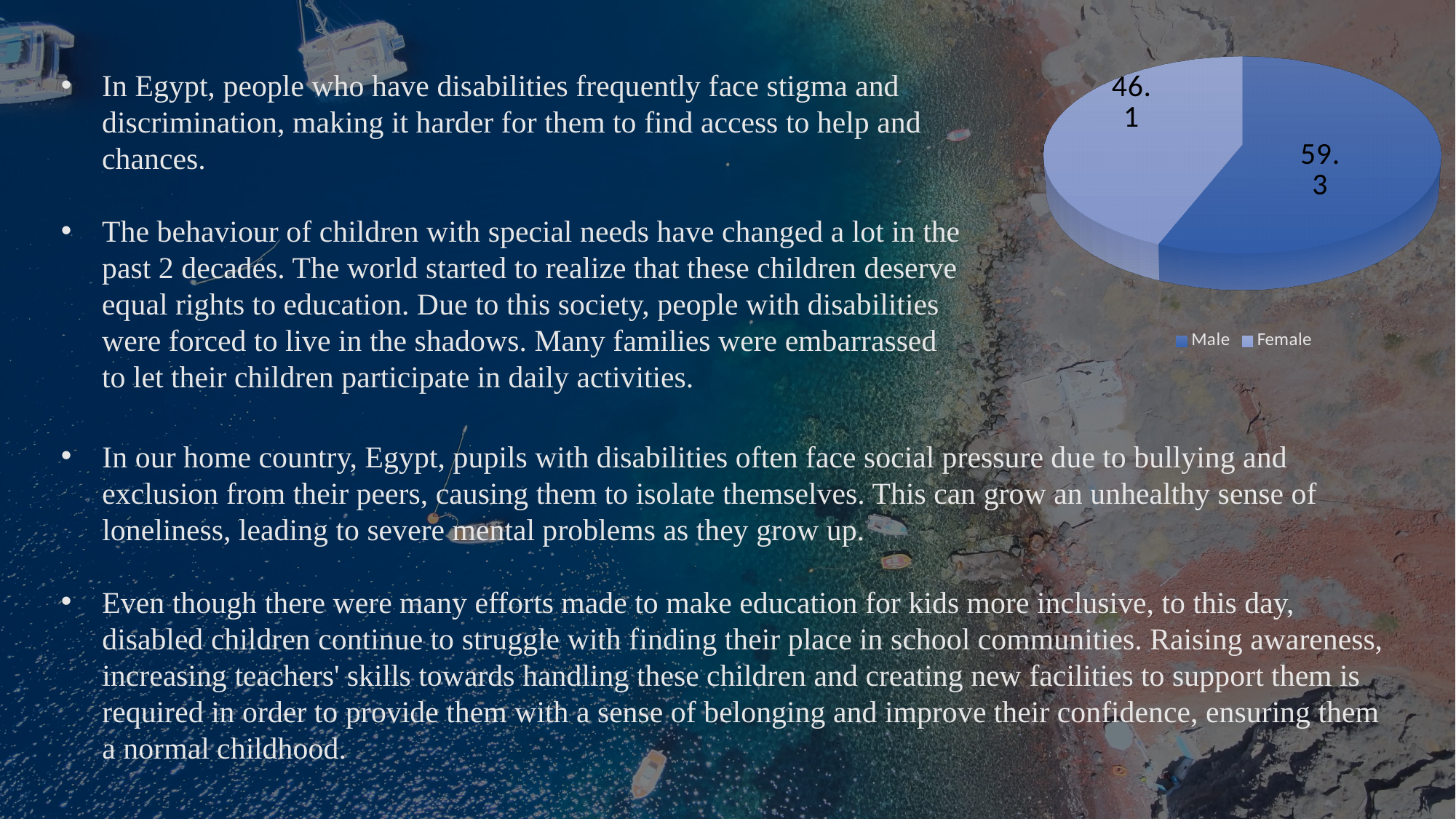
What value is shown for the Female slice of the pie chart? 46.1 What value is shown for the Male slice of the pie chart? 59.3 What kind of chart is shown on the slide? pie chart Which slice of the pie chart is shown in the darker blue colour? Male Which slice of the pie chart has the smallest value? Female What are the two legend entries of the pie chart? Male and Female How many entries does the legend of the pie chart list? 2 Which is larger in the pie chart, the Male value or the Female value? Male What is the difference between the Male and Female values in the pie chart? 13.2 How many slices does the pie chart have? 2 Which slice of the pie chart has the largest value? Male